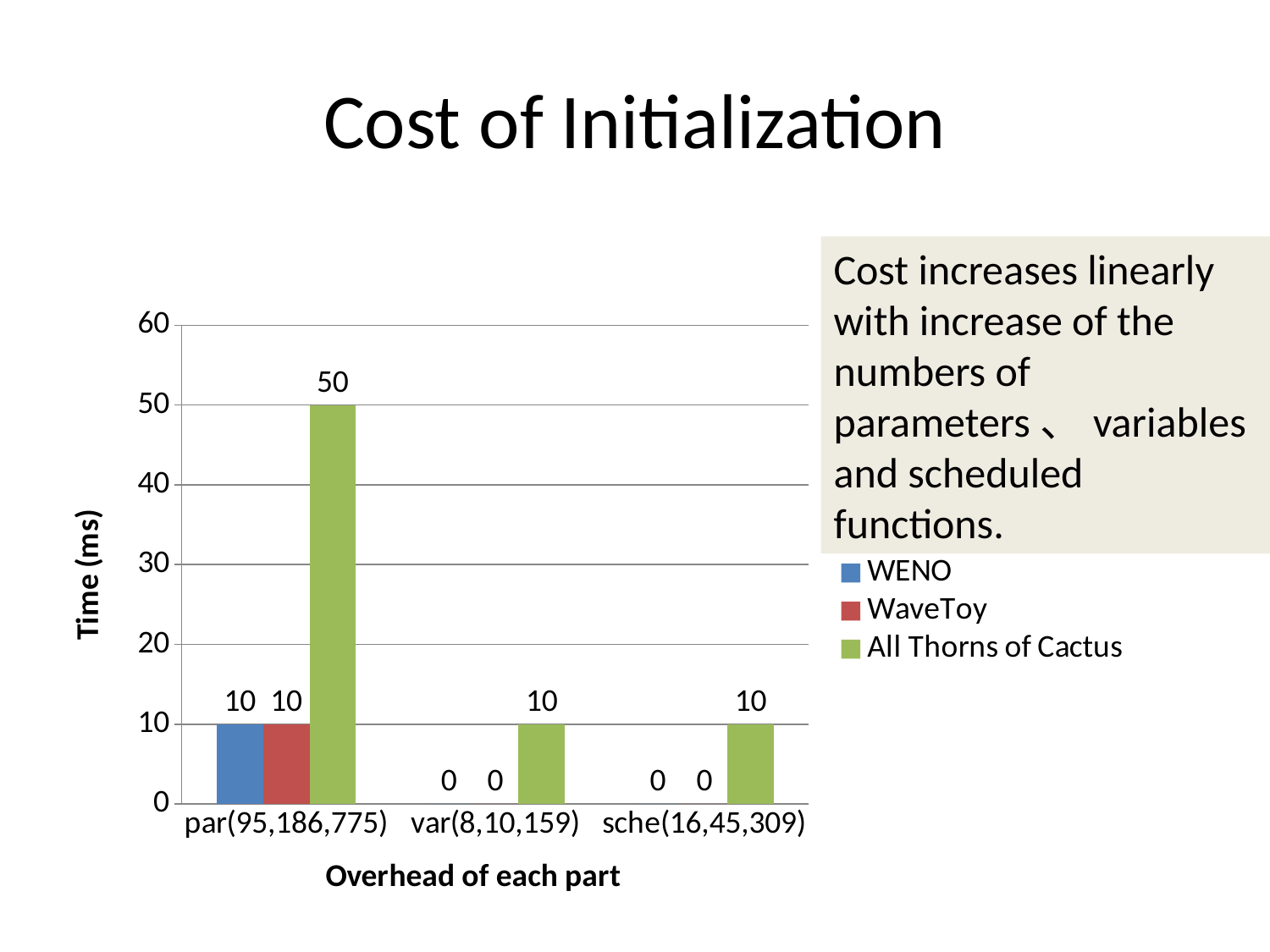
What is the value for WENO in the par(95,186,775) category? 10 How many series does the legend list? 3 What kind of chart is shown on the slide? Bar chart How many categories are shown on the x axis? 3 What is the label of the y axis? Time (ms) What is the difference between the All Thorns of Cactus value and the WENO value in the par(95,186,775) category? 40 What is the label of the x axis? Overhead of each part What is the value for All Thorns of Cactus in the par(95,186,775) category? 50 Which category has the highest value for All Thorns of Cactus? par(95,186,775) What is the value for All Thorns of Cactus in the sche(16,45,309) category? 10 Which is larger in the par(95,186,775) category: the WaveToy value or the All Thorns of Cactus value? All Thorns of Cactus What is the value for WaveToy in the var(8,10,159) category? 0